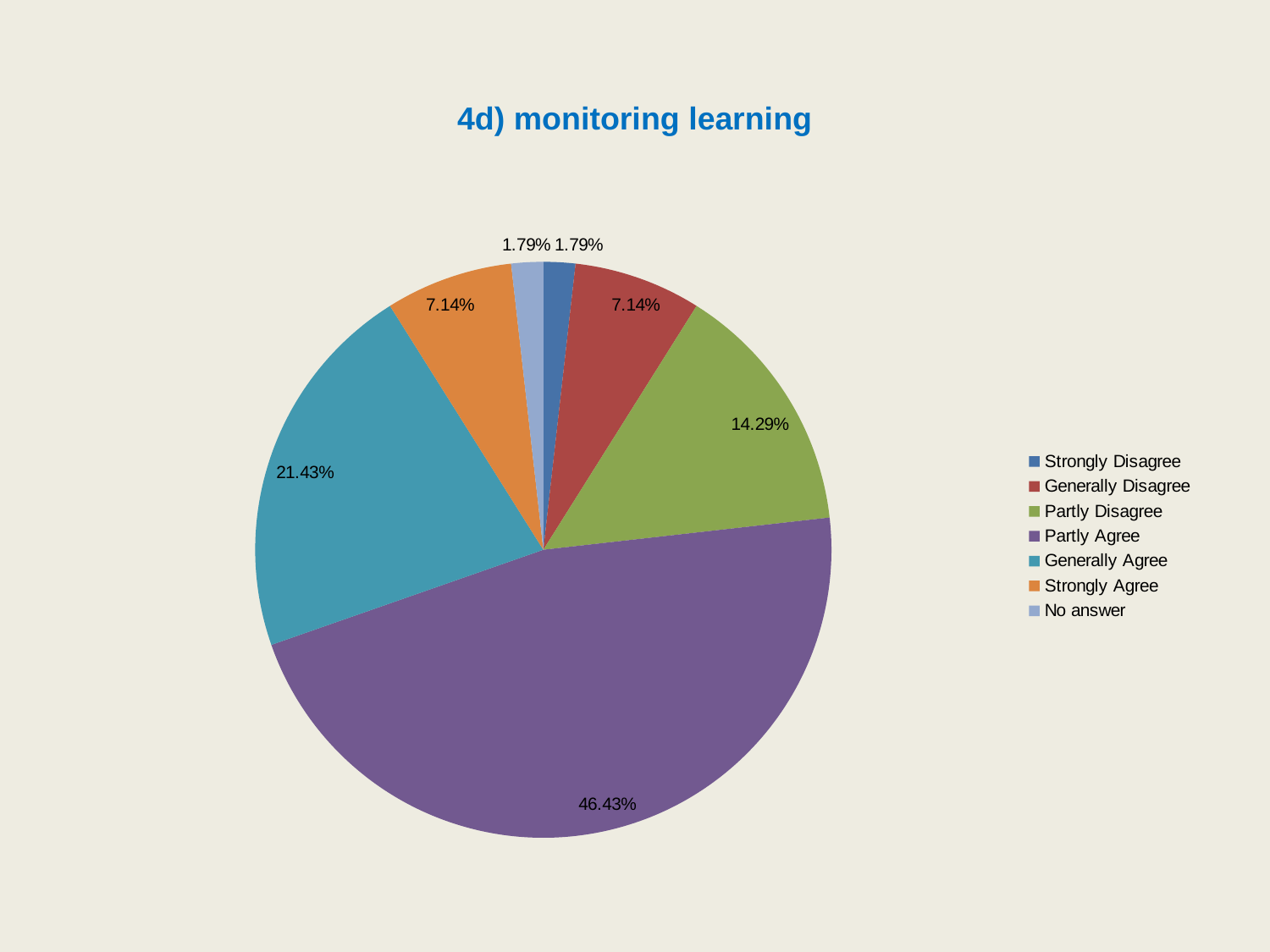
What is the difference between the Partly Agree share and the Generally Agree share? 25.00% What percentage of the pie is Partly Agree? 46.43% What percentage of the pie is Partly Disagree? 14.29% What is the chart's title? 4d) monitoring learning What percentage of the pie is Generally Agree? 21.43% Which category has the largest share of the pie? Partly Agree What percentage of the pie is Strongly Agree? 7.14% What colour is the Partly Agree slice? purple How many categories does the legend list? 7 What kind of chart is shown on the slide? pie chart Which is larger, Generally Agree or Partly Disagree? Generally Agree What percentage of the pie is No answer? 1.79%